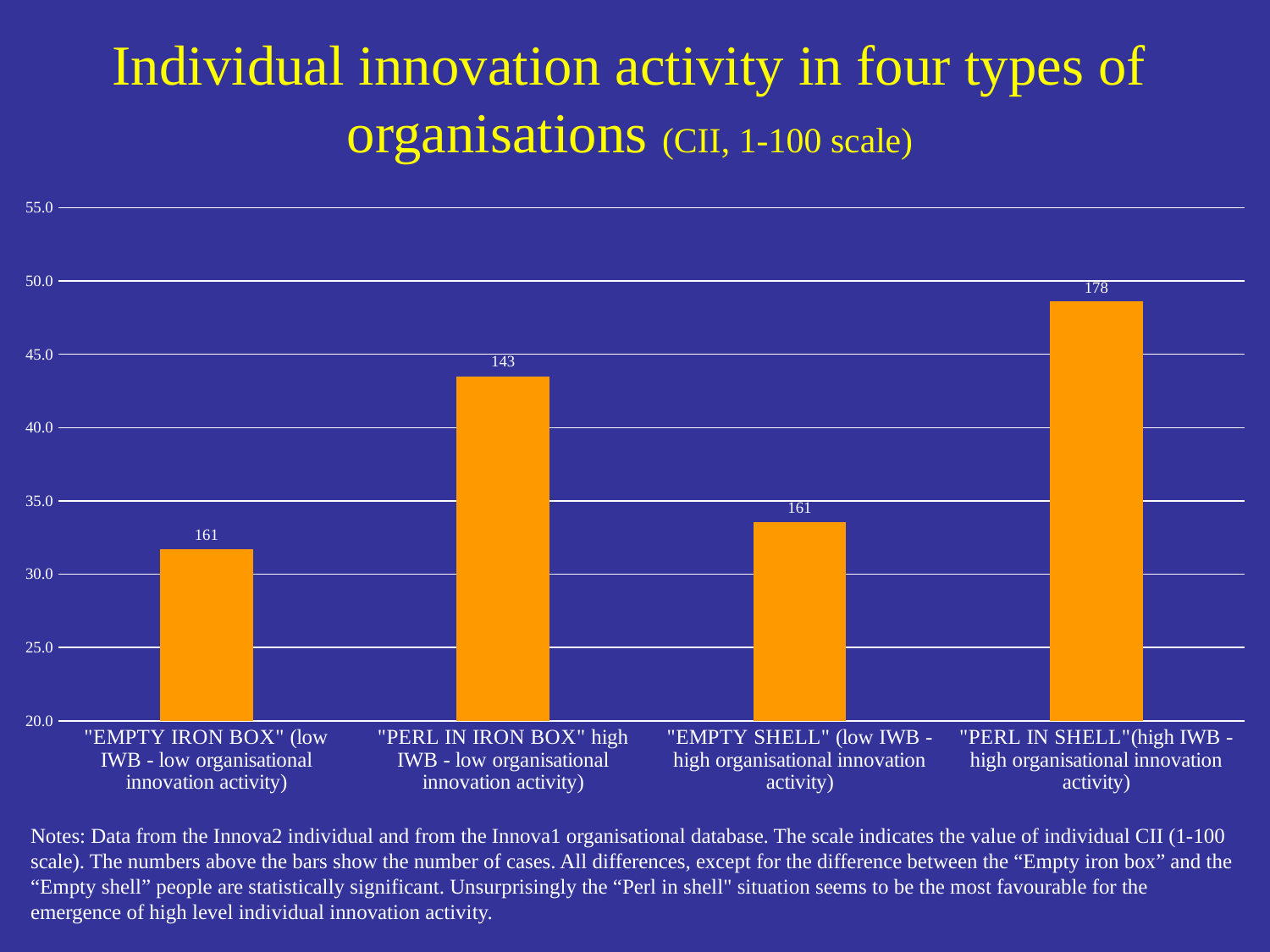
Which type of organisation has the highest individual innovation activity (CII) in the chart? "PERL IN SHELL" (high IWB - high organisational innovation activity) Which type of organisation has the lowest individual innovation activity (CII) in the chart? "EMPTY IRON BOX" (low IWB - low organisational innovation activity) Which has a higher CII value: "PERL IN IRON BOX" or "EMPTY SHELL"? "PERL IN IRON BOX" What kind of chart is shown on the slide? bar chart Is the CII value for "EMPTY SHELL" greater or less than 35.0? less According to the number printed above the bar, how many cases are there for "PERL IN IRON BOX"? 143 Is the CII value for "PERL IN SHELL" greater or less than 45.0? greater Is the CII value for "PERL IN IRON BOX" greater or less than 45.0? less How many types of organisations (bars) are shown in the chart? 4 According to the number printed above the bar, how many cases are there for "PERL IN SHELL"? 178 What colour are the bars in the chart? orange